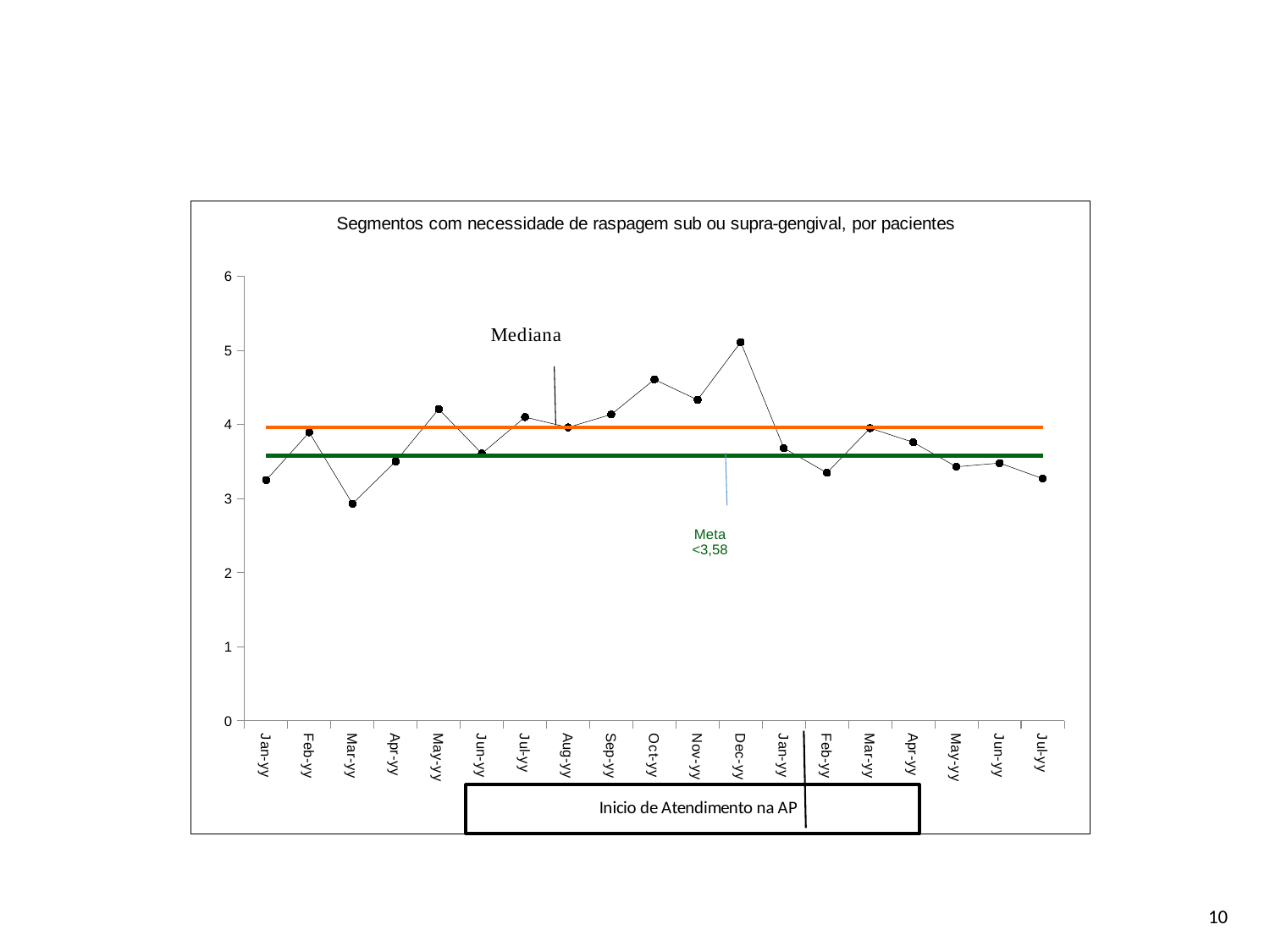
Which is larger, the value for Dec-yy or the value for Mar-yy? Dec-yy Is the value for Dec-yy greater or less than 4? greater What is the title of the chart? Segmentos com necessidade de raspagem sub ou supra-gengival, por pacientes How many monthly data points are plotted on the line? 19 From Dec-yy to the following Feb-yy, do the plotted values rise or fall? fall Which month has the highest plotted value? Dec-yy Which is larger, the value for Oct-yy or the value for the last Jul-yy point? Oct-yy What kind of chart is shown on the slide? line chart Is the value for Oct-yy greater or less than 4? greater Which month has the lowest plotted value? Mar-yy What target (Meta) value is annotated on the chart? <3,58 Is the value for the first Jan-yy point greater or less than 4? less